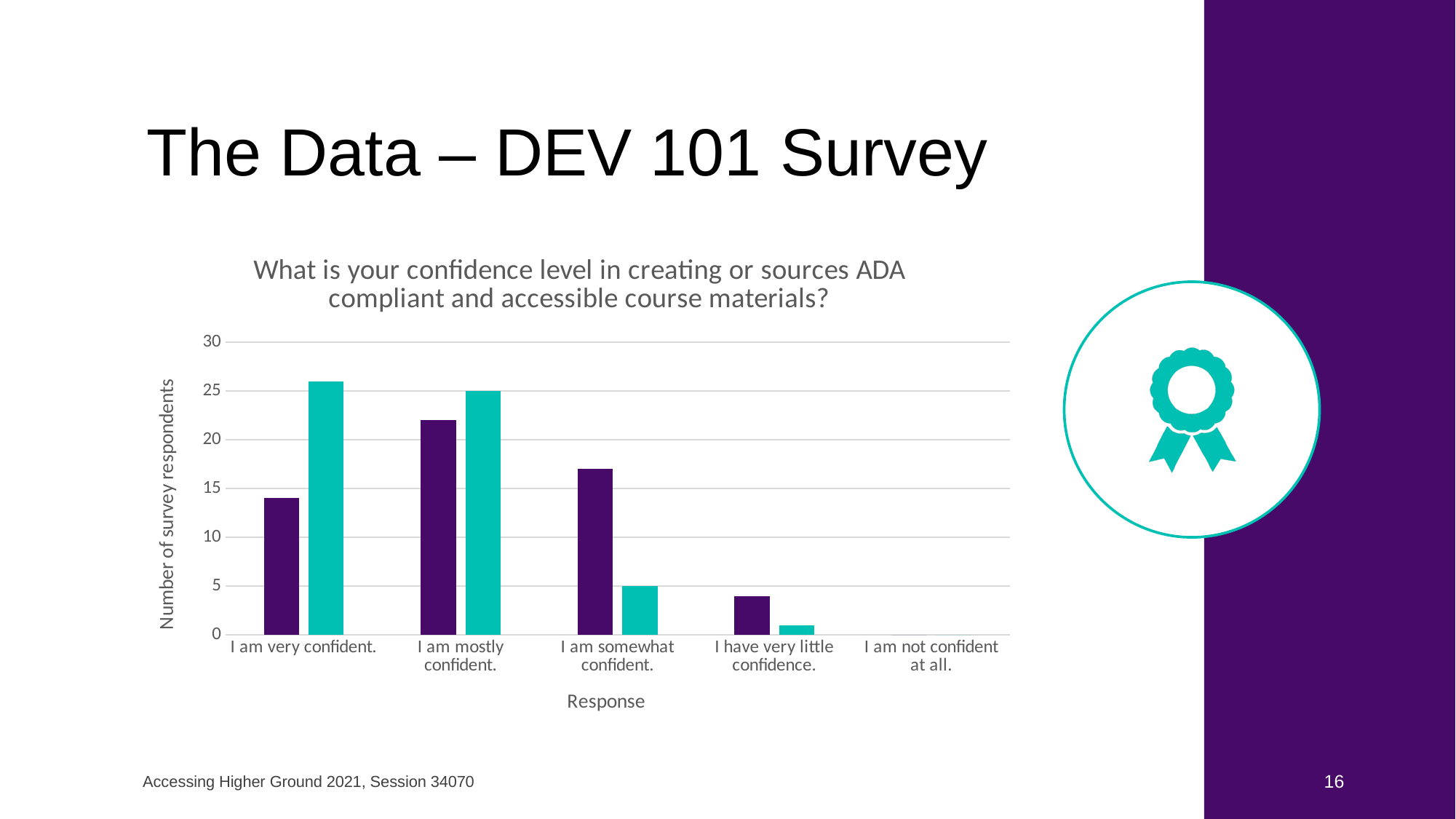
Is the purple bar for "I am very confident." greater or less than 10? greater What is the label of the vertical axis? Number of survey respondents Is the purple bar for "I have very little confidence." greater or less than 5? less What is the title of the chart? What is your confidence level in creating or sources ADA compliant and accessible course materials? What is the value of the teal bar for "I am mostly confident."? 25 Which response category has the tallest purple bar? I am mostly confident. Which response category has the tallest teal bar? I am very confident. What is the value of the teal bar for "I am somewhat confident."? 5 How many response categories are shown on the x axis? 5 What kind of chart is shown on the slide? bar chart For "I am somewhat confident.", which bar is larger, the purple one or the teal one? purple Is the purple bar for "I am mostly confident." greater or less than 20? greater